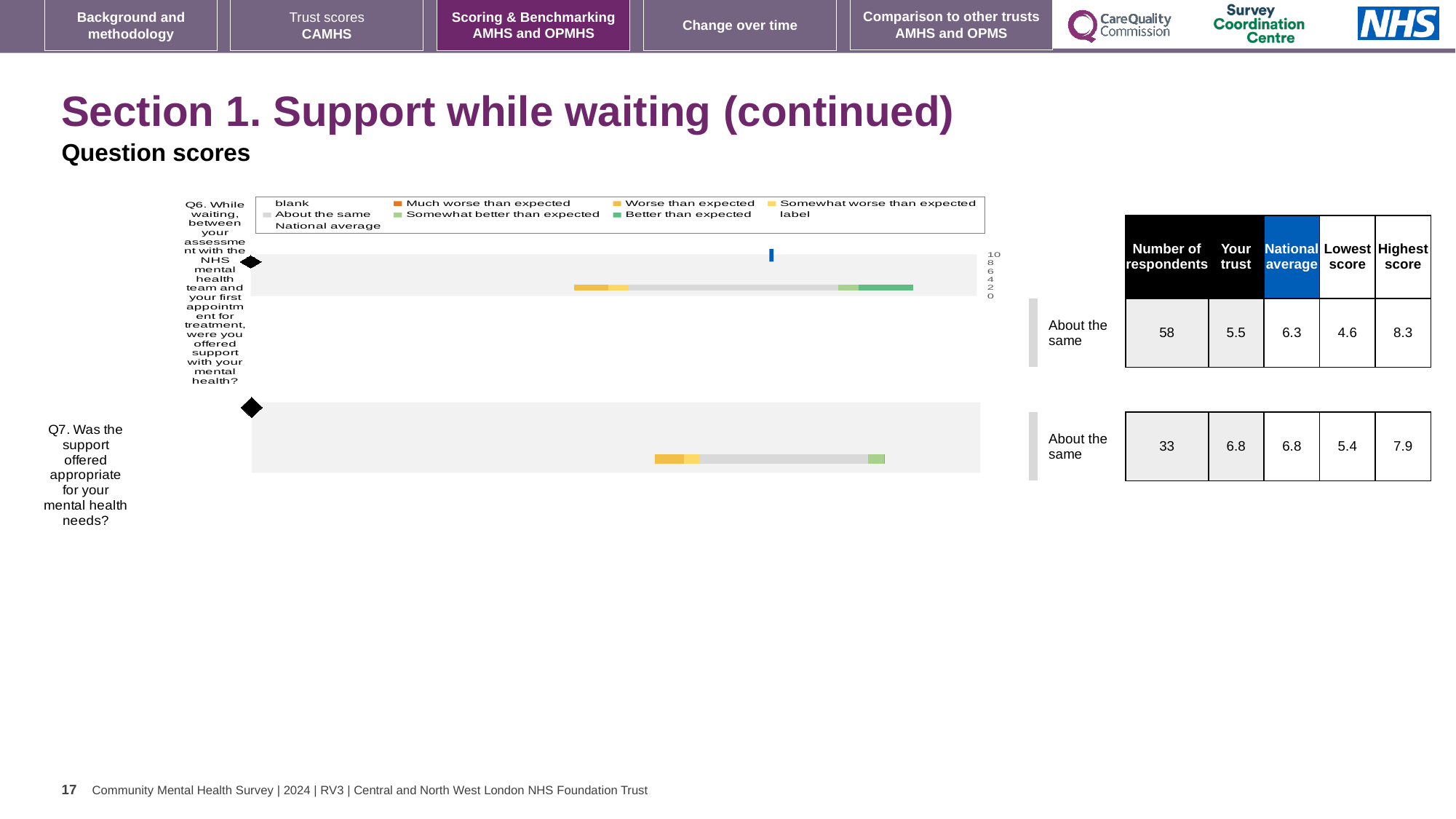
Which benchmark category is the trust placed in for Q6? About the same What is the highest score shown for Q7? 7.9 How many respondents answered Q7 (Was the support offered appropriate for your mental health needs)? 33 What is the 'Your trust' score for Q6 (support while waiting between assessment and first appointment)? 5.5 What kind of chart is used to show the question scores on this slide? bar chart What is the lowest score shown for Q6? 4.6 What is the difference between the highest and lowest scores for Q7? 2.5 What is the difference between the highest and lowest scores for Q6? 3.7 Is the trust's score for Q7 higher than, lower than, or the same as the national average? the same How many questions are plotted in the chart on this slide? 2 For Q6, which is larger: the trust's score or the national average? national average What is the national average score for Q6? 6.3